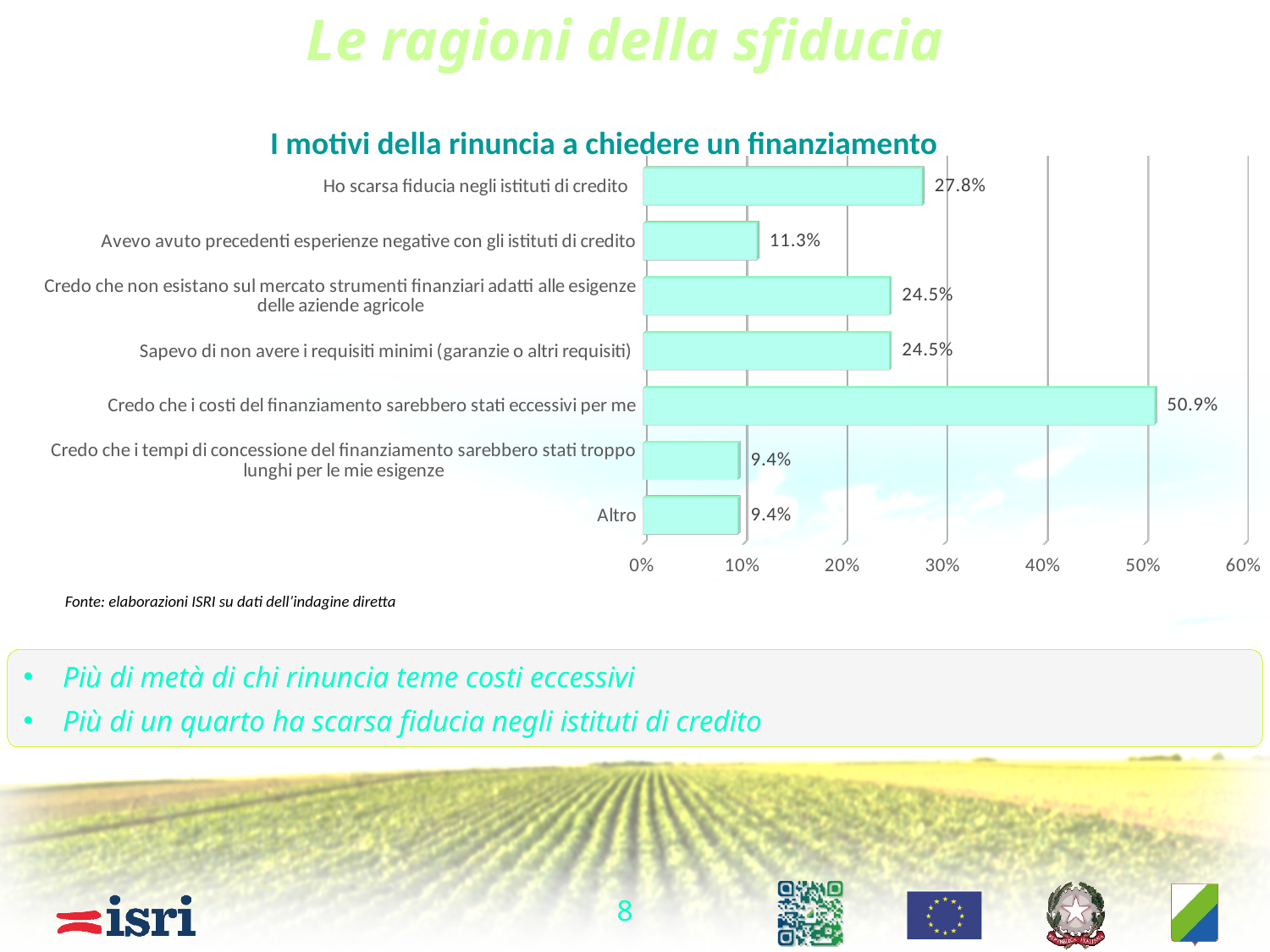
What kind of chart is shown on the slide? Bar chart What is the value for "Ho scarsa fiducia negli istituti di credito"? 27.8% Which is larger: the value for "Ho scarsa fiducia negli istituti di credito" or for "Sapevo di non avere i requisiti minimi (garanzie o altri requisiti)"? Ho scarsa fiducia negli istituti di credito What is the value for "Avevo avuto precedenti esperienze negative con gli istituti di credito"? 11.3% What is the value for "Credo che i costi del finanziamento sarebbero stati eccessivi per me"? 50.9% What is the value for "Altro"? 9.4% Is the value for "Credo che i costi del finanziamento sarebbero stati eccessivi per me" greater or less than 40%? greater How many categories are shown in the chart? 7 Which category has the highest value? Credo che i costi del finanziamento sarebbero stati eccessivi per me What is the maximum value shown on the x axis? 60% What is the difference between the values for "Credo che i costi del finanziamento sarebbero stati eccessivi per me" and "Ho scarsa fiducia negli istituti di credito"? 23.1% What is the title of the chart? I motivi della rinuncia a chiedere un finanziamento